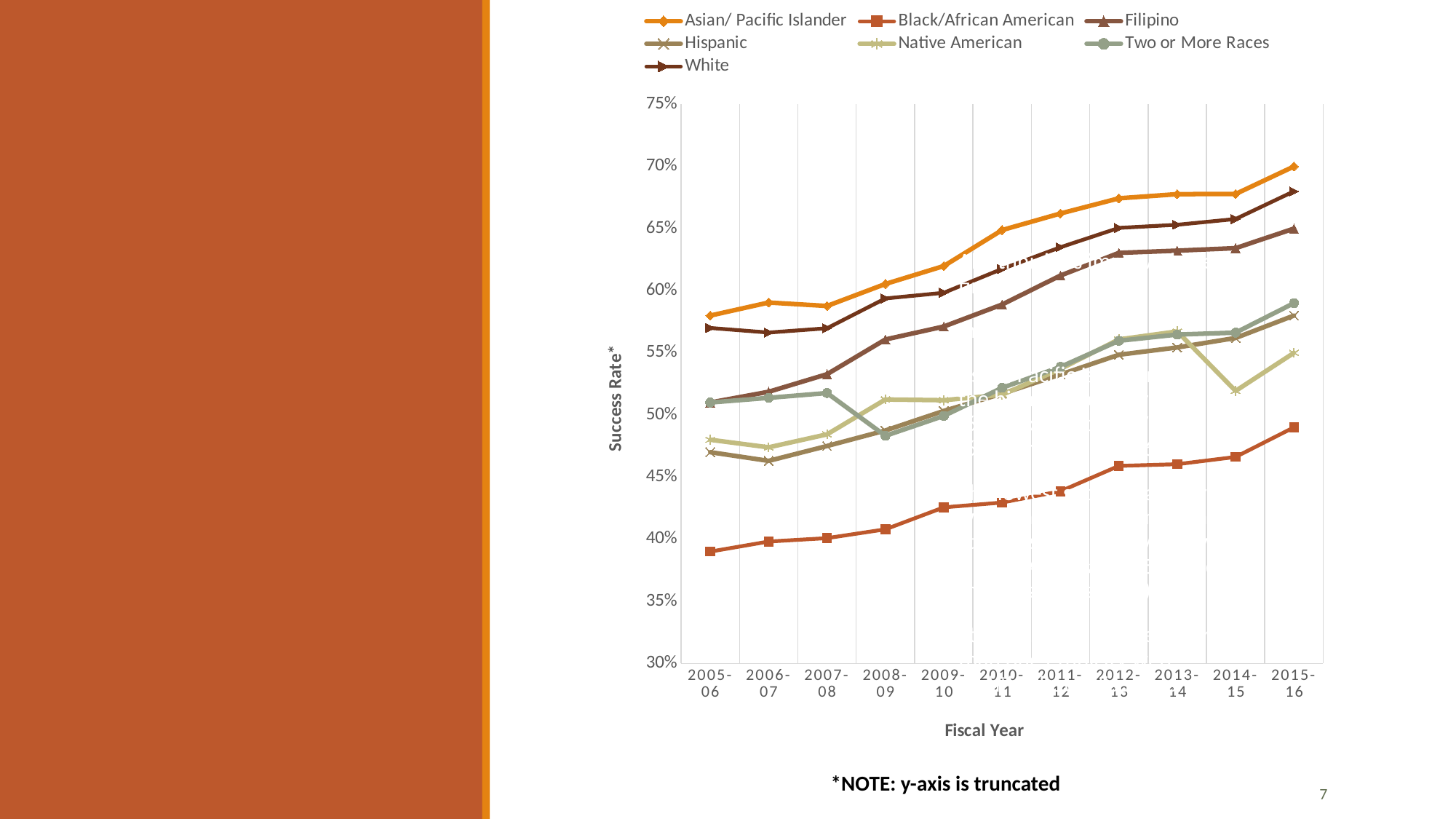
Does the success rate for Asian/ Pacific Islander generally rise or fall from 2005-06 to 2015-16? rise How many series does the legend list? 7 In 2015-16, which is larger: the success rate for White or for Filipino? White What kind of chart is shown on the slide? line chart What is the label on the y axis of the chart? Success Rate* Is the value for Asian/ Pacific Islander in 2015-16 greater or less than 65%? greater How many fiscal years are plotted along the x axis? 11 Which group has the highest success rate in 2015-16? Asian/ Pacific Islander Which group has the lowest success rate in 2015-16? Black/African American Is the value for Black/African American in 2009-10 greater or less than 40%? greater Is the value for Native American in 2014-15 greater or less than 55%? less Which group has the lowest success rate in 2005-06? Black/African American